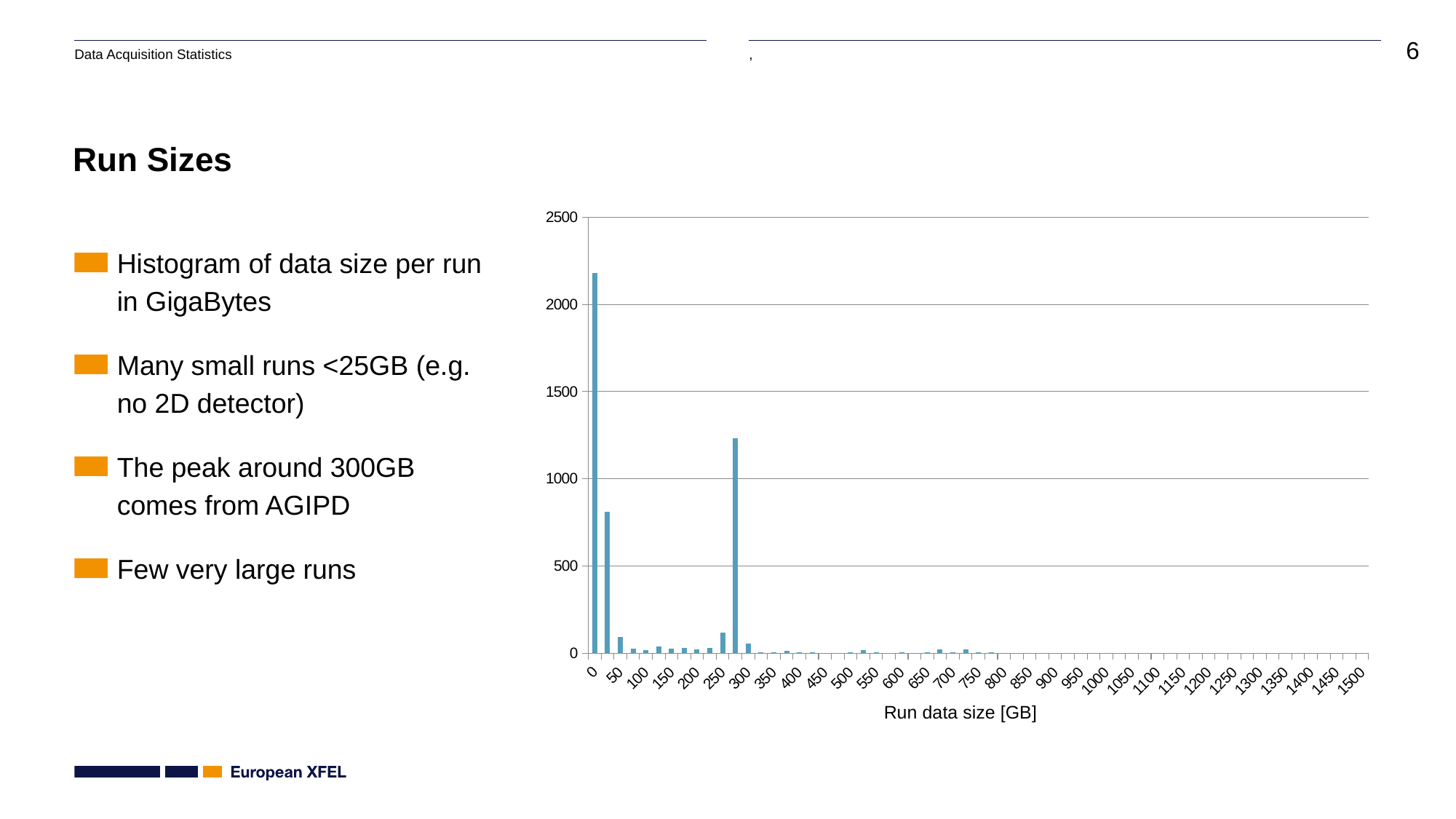
What is the x-axis title of the chart? Run data size [GB] Is the value of the second bar (just right of the 0 GB tick) greater or less than 500? greater Beyond the peak near 300 GB, do the bar heights generally rise or fall as run data size increases? fall Is the value of the second bar (just right of the 0 GB tick) greater or less than 1000? less Which is taller: the bar at 0 GB or the tall bar near 300 GB? the bar at 0 GB Is the value of the tallest bar (at 0 GB) greater or less than 2000? greater What is the largest value labelled on the x-axis? 1500 What kind of chart is shown on the slide? bar chart What is the highest tick label shown on the y-axis? 2500 At which x-axis value does the tallest bar of the histogram appear? 0